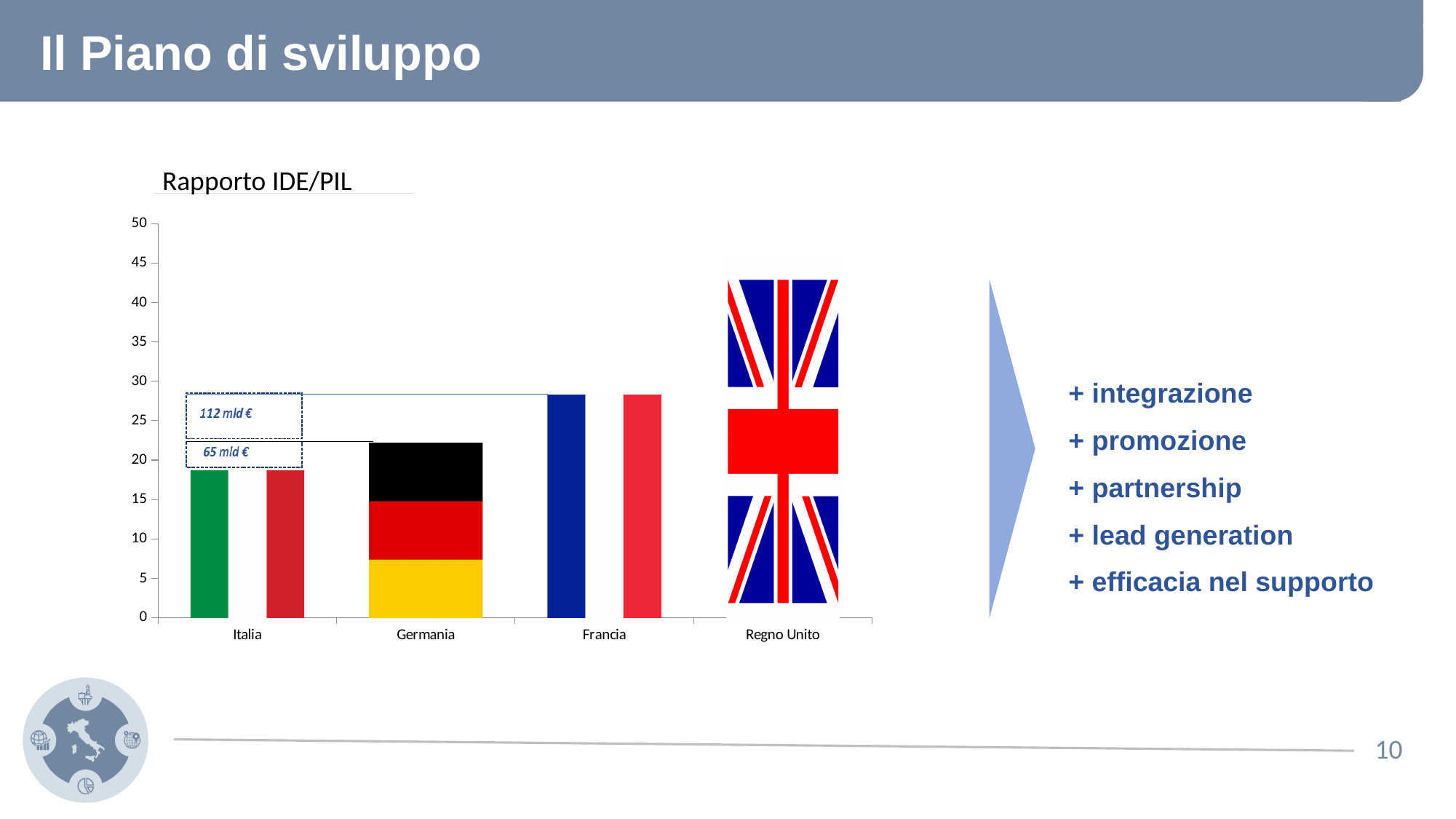
What are the two annotation labels shown in the dashed boxes above the Italia bars? 112 mld € and 65 mld € What is the title of the chart? Rapporto IDE/PIL Which country has the lowest value in the chart? Italia Is the value for Italia greater or less than 15? greater Which has a larger value, Francia or Germania? Francia Do the values rise or fall moving from Italia to Regno Unito along the x axis? rise Which country has the highest value in the chart? Regno Unito Is the value for Regno Unito greater or less than 40? greater What kind of chart is shown on the slide? bar chart Is the value for Francia greater or less than 30? less How many countries are shown on the x axis of the chart? 4 Which has a larger value, Regno Unito or Italia? Regno Unito